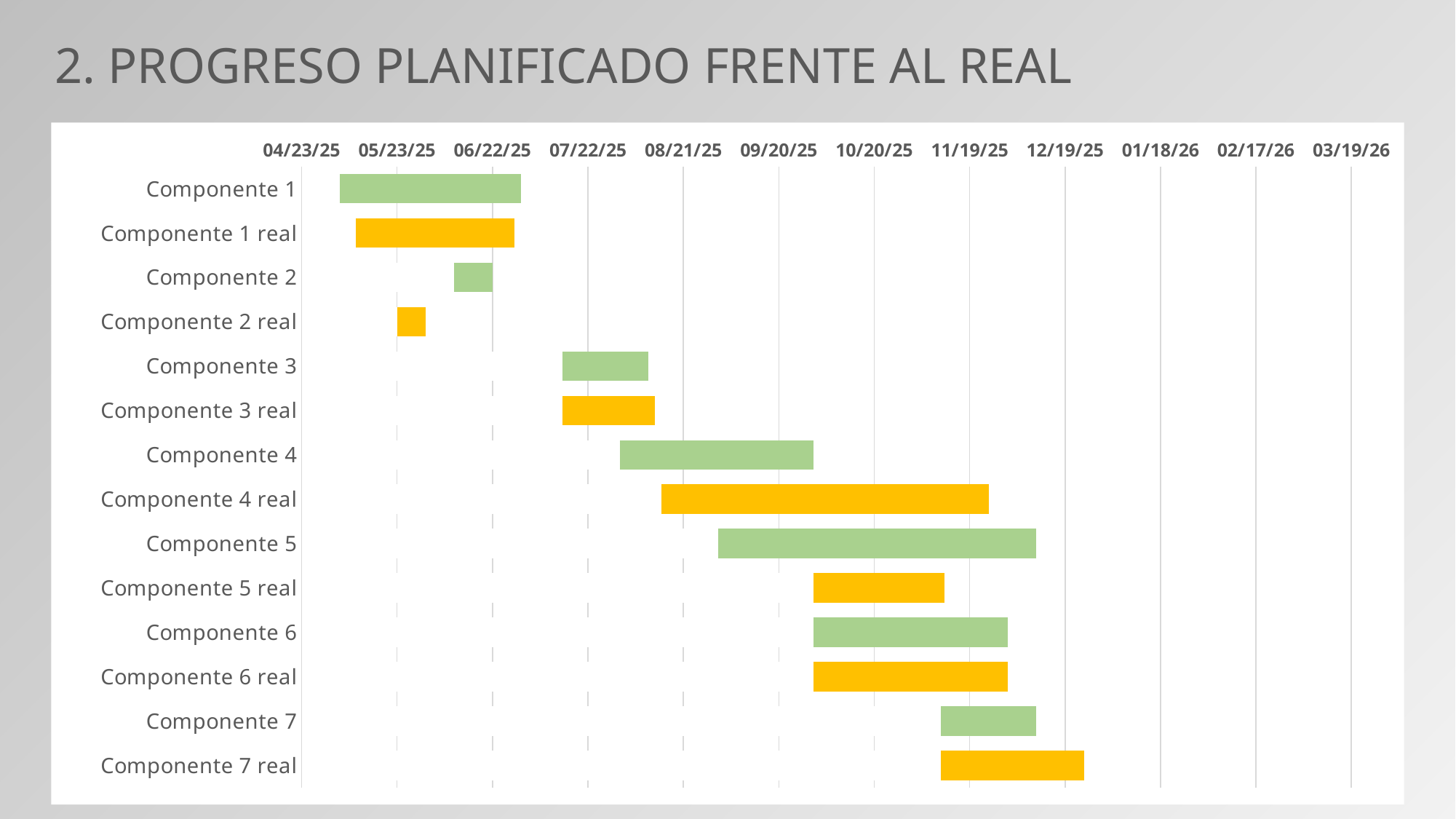
Which bar is longer, Componente 4 or Componente 4 real? Componente 4 real How many rows (categories) are plotted on the chart? 14 Does the Componente 7 real bar end before or after 12/19/25? after Which row has the shortest bar on the chart? Componente 2 real How many components are compared (planned vs real) on the chart? 7 What kind of chart is shown on the slide? Bar chart (Gantt chart) Which bar is longer, Componente 7 or Componente 7 real? Componente 7 real Which bar is longer, Componente 5 or Componente 5 real? Componente 5 Does the Componente 4 real bar start before or after 08/21/25? before What is the title of the slide? 2. PROGRESO PLANIFICADO FRENTE AL REAL What colour are the bars for the 'real' rows? Yellow/orange